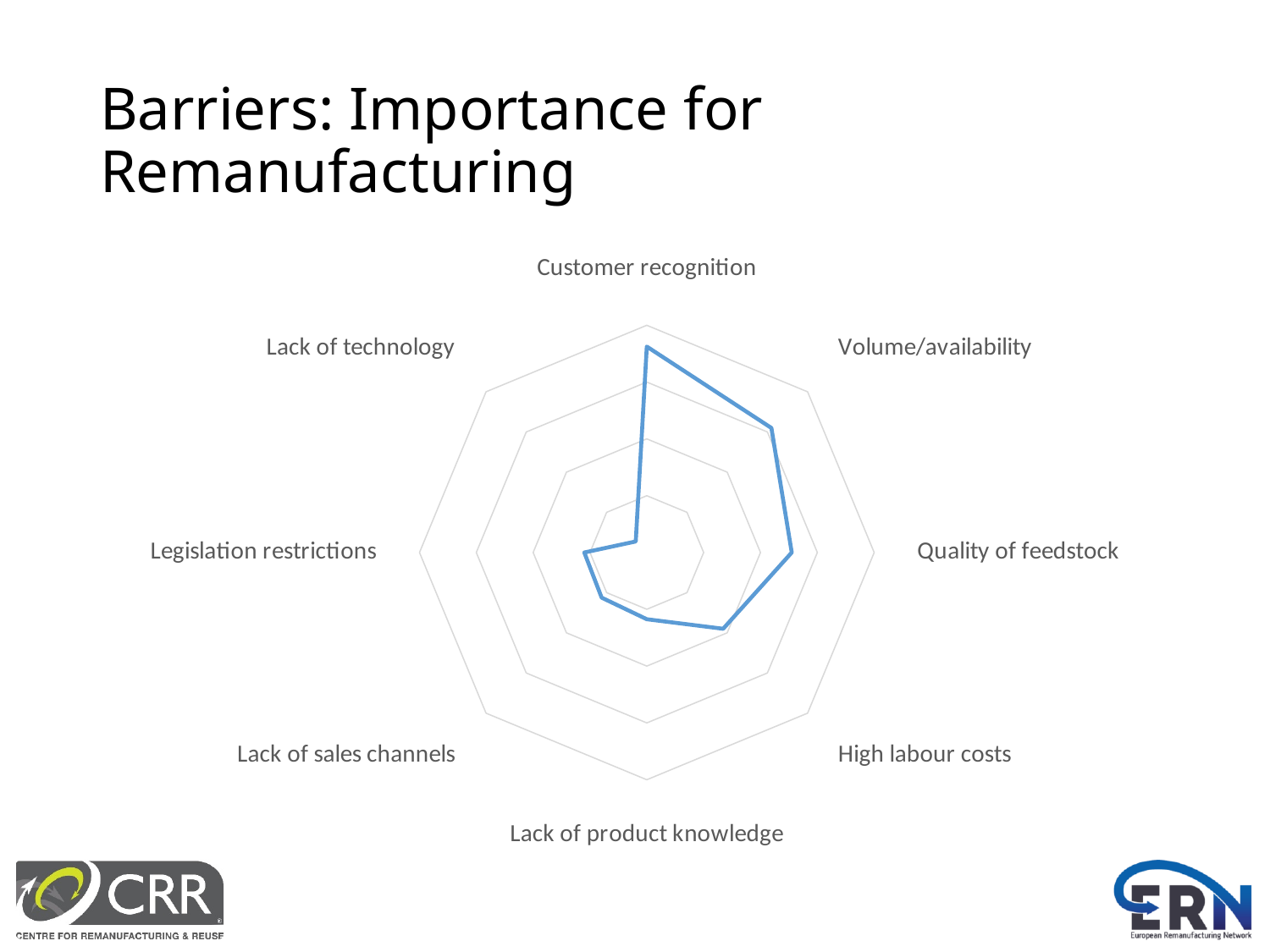
Which has the larger value: Volume/availability or Legislation restrictions? Volume/availability Which barrier has the highest importance value on the chart? Customer recognition What kind of chart is shown on the slide? Radar chart Which has the larger value: Quality of feedstock or Lack of sales channels? Quality of feedstock Which barrier has the lowest importance value on the chart? Lack of technology Which has the larger value: High labour costs or Lack of technology? High labour costs Which category is positioned at the top of the radar chart? Customer recognition How many barrier categories are plotted on the radar chart? 8 What is the title of the slide containing the radar chart? Barriers: Importance for Remanufacturing